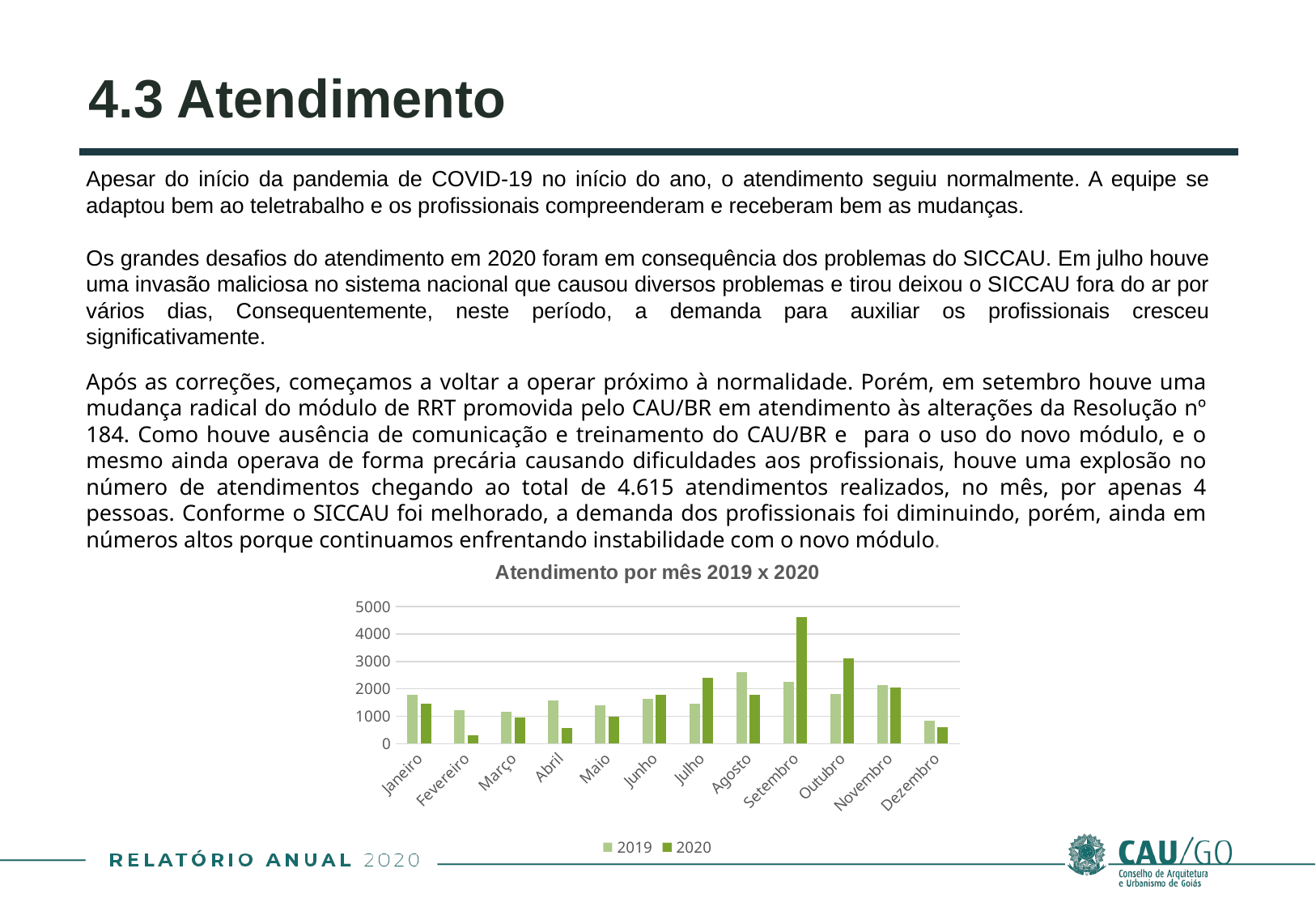
What kind of chart is shown on the slide? bar chart How many months are shown on the x axis of the chart? 12 For Julho, which series has the larger value, 2019 or 2020? 2020 In which month is the 2020 value lowest? Fevereiro In which month is the 2020 value highest? Setembro How many series does the chart legend list? 2 What is the title of the chart? Atendimento por mês 2019 x 2020 In which month is the 2019 value highest? Agosto Is the 2020 value for Setembro greater or less than 4000? greater Is the 2020 value for Fevereiro greater or less than 1000? less For Agosto, which series has the larger value, 2019 or 2020? 2019